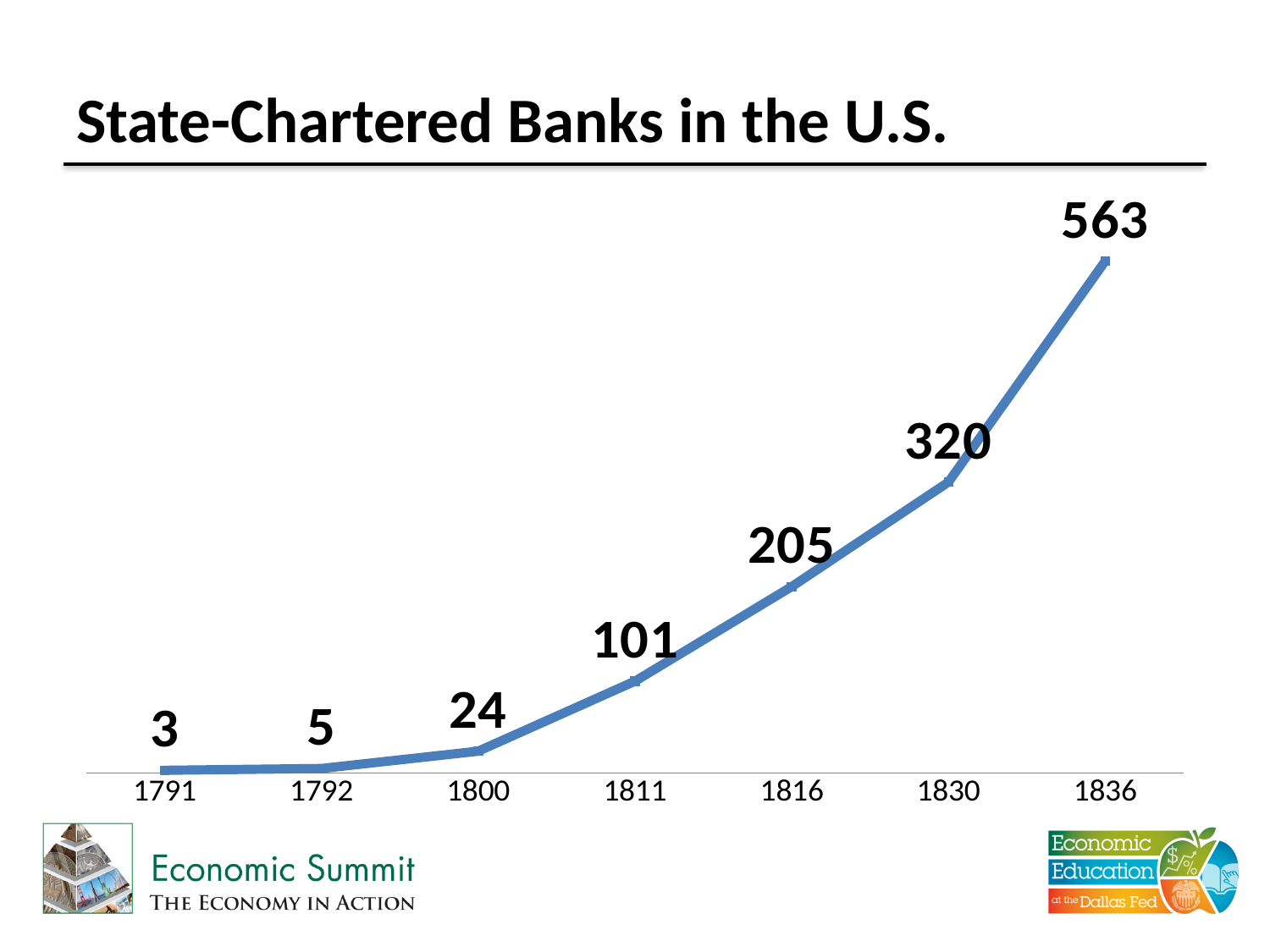
What is the number of state-chartered banks in 1791? 3 What is the difference between the number of banks in 1836 and in 1830? 243 Which year has more state-chartered banks, 1800 or 1816? 1816 What is the number of state-chartered banks in 1836? 563 What is the difference between the number of banks in 1816 and in 1811? 104 Which year has the lowest number of state-chartered banks? 1791 What kind of chart is shown on the slide? Line chart What is the number of state-chartered banks in 1830? 320 Which year has the highest number of state-chartered banks? 1836 What is the number of state-chartered banks in 1811? 101 How many years are plotted on the chart? 7 Do the values rise or fall from 1791 to 1836? Rise